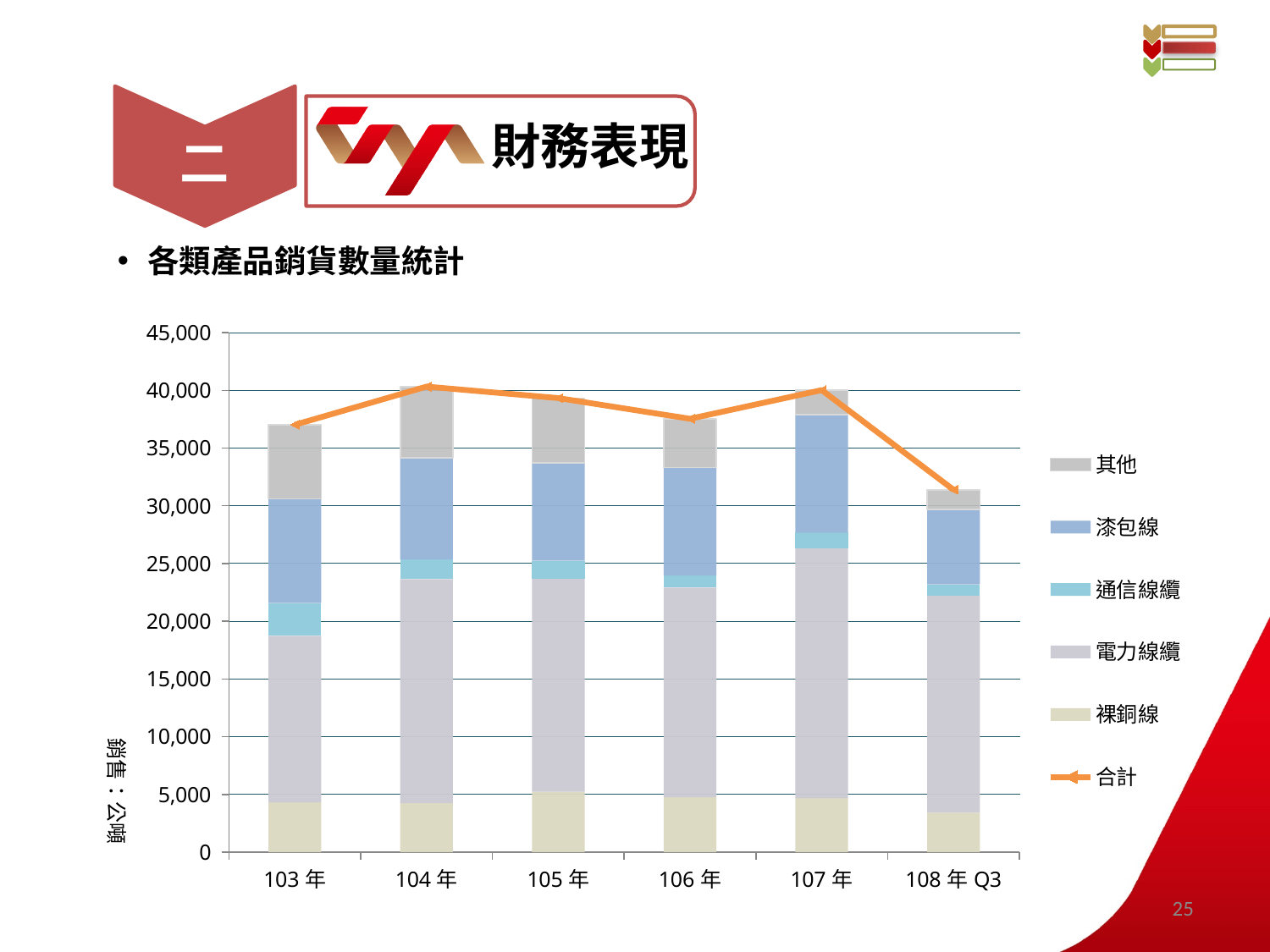
Which category has the lowest total (合計) in the chart? 108 年 Q3 Is the total (合計) for 106 年 greater or less than 40,000? less What is the title of the vertical axis of the chart? 銷售：公噸 Does the total (合計) line rise or fall from 107 年 to 108 年 Q3? fall Which legend entry is plotted as a line rather than a bar segment? 合計 How many categories are shown on the x axis of the chart? 6 Which is larger, the 電力線纜 segment for 107 年 or for 103 年? 107 年 Is the total (合計) for 108 年 Q3 greater or less than 35,000? less How many series does the chart's legend list? 6 What kind of chart is shown on the slide? A stacked bar chart with a line for the total Which is larger, the total (合計) for 103 年 or for 108 年 Q3? 103 年 Is the total (合計) for 103 年 greater or less than 35,000? greater